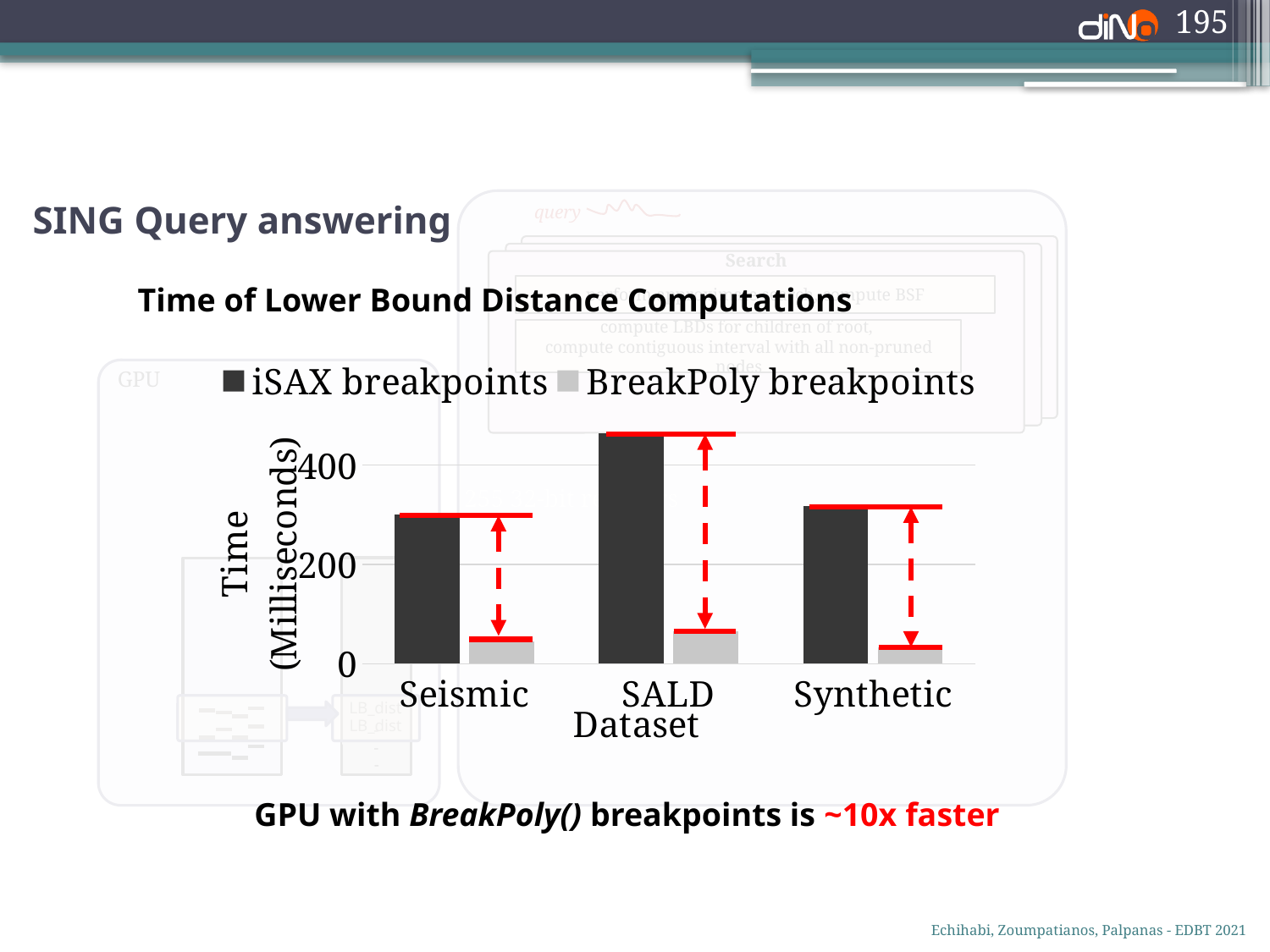
Is the BreakPoly breakpoints value for Synthetic greater or less than 200? less For the Synthetic dataset, which series has the larger value: iSAX breakpoints or BreakPoly breakpoints? iSAX breakpoints Which dataset has the highest iSAX breakpoints time? SALD What kind of chart is shown on the slide? bar chart What is the label of the x axis of the chart? Dataset Is the iSAX breakpoints value for Seismic greater or less than 200? greater How many series does the chart legend list? 2 What is the label of the y axis of the chart? Time (Milliseconds) Is the BreakPoly breakpoints value for SALD greater or less than 200? less Which is larger: the iSAX breakpoints value for SALD or for Seismic? SALD How many datasets are shown on the x axis of the chart? 3